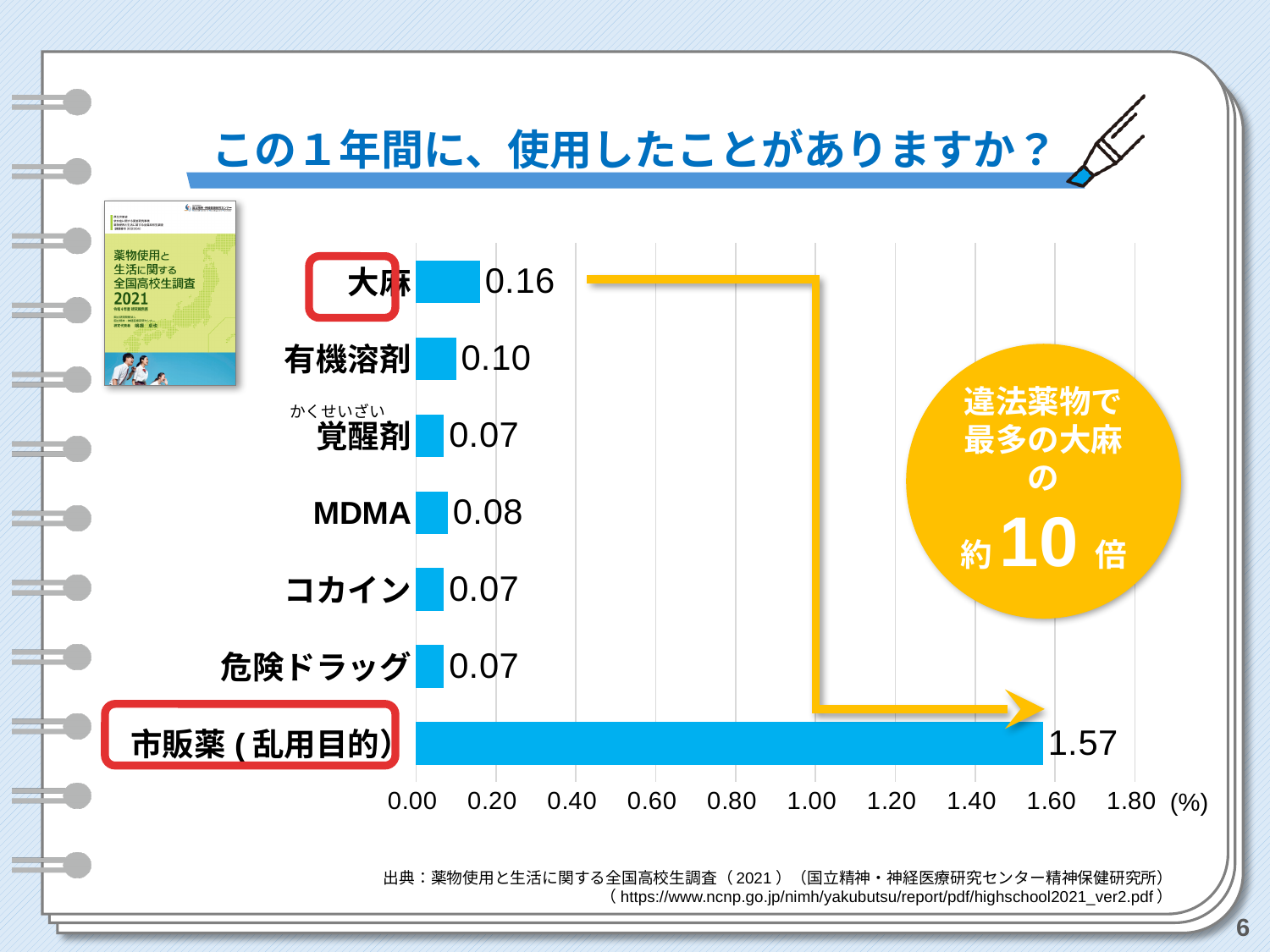
What is the difference between the values for 大麻 and 有機溶剤? 0.06 What is the value for 有機溶剤? 0.10 What is the value for MDMA? 0.08 Which category has the highest value? 市販薬(乱用目的) How many categories are shown in the chart? 7 Which category has the highest value among the illegal drugs (excluding 市販薬)? 大麻 Is the value for 市販薬(乱用目的) greater or less than 1.40? greater What kind of chart is shown on the slide? bar chart What is the value for 大麻? 0.16 What is the difference between the values for 市販薬(乱用目的) and 大麻? 1.41 Which is larger, the value for MDMA or the value for コカイン? MDMA What is the value for 市販薬(乱用目的)? 1.57